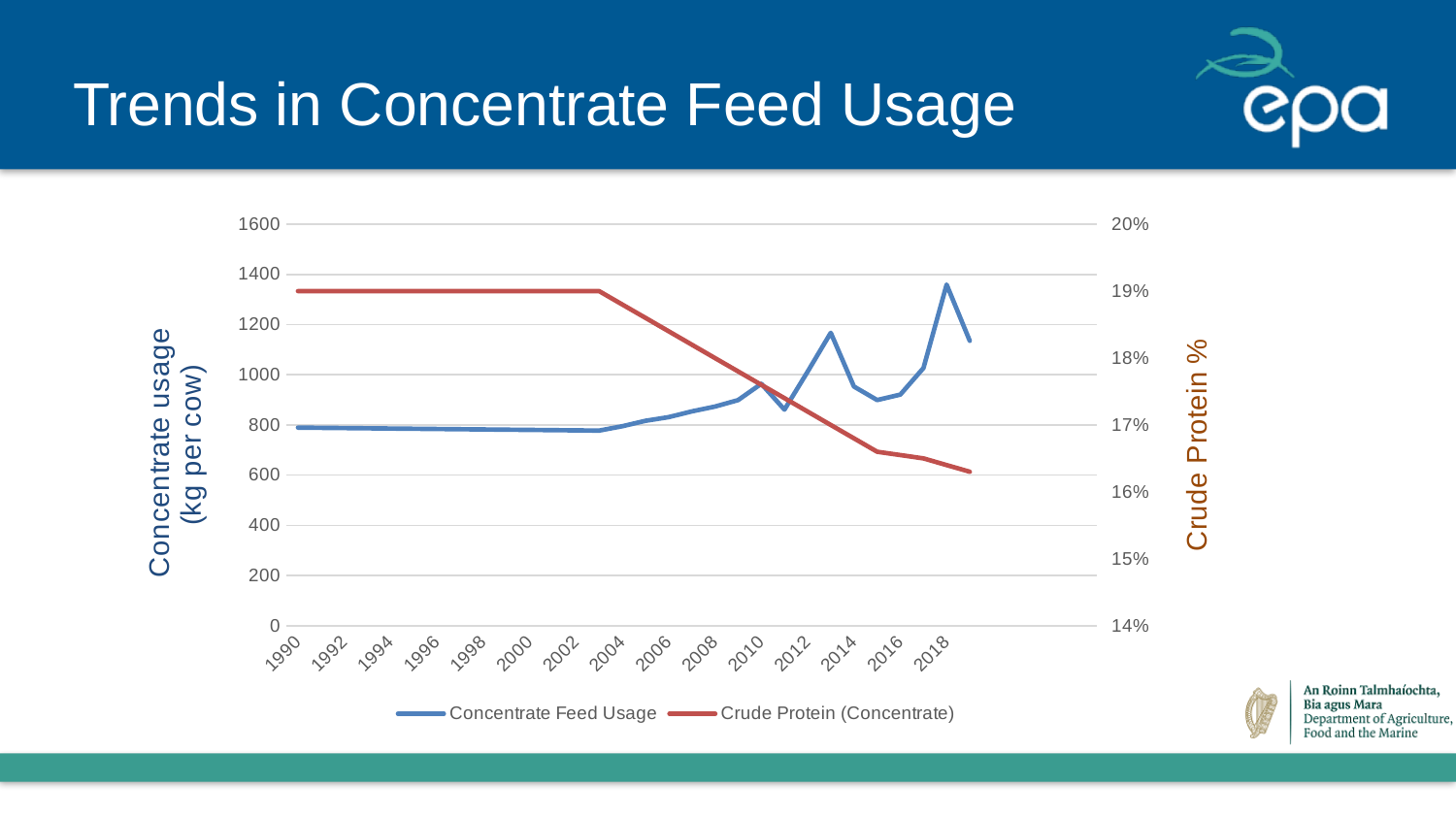
Is the Crude Protein (Concentrate) value for 1996 greater or less than 18%? greater What kind of chart is shown on the slide? line chart How many series does the legend list? 2 Is the Crude Protein (Concentrate) value for 2018 greater or less than 17%? less Does the Crude Protein (Concentrate) series rise or fall between 2004 and 2018? fall Does the Concentrate Feed Usage series generally rise or fall from 1990 to 2018? rise Which year has the larger Concentrate Feed Usage value, 2010 or 2018? 2018 What is the title of the left vertical axis? Concentrate usage (kg per cow) Is the Concentrate Feed Usage value for 2018 greater or less than 1200? greater In which year does the Concentrate Feed Usage series reach its highest value? 2018 What are the two series named in the legend? Concentrate Feed Usage and Crude Protein (Concentrate)